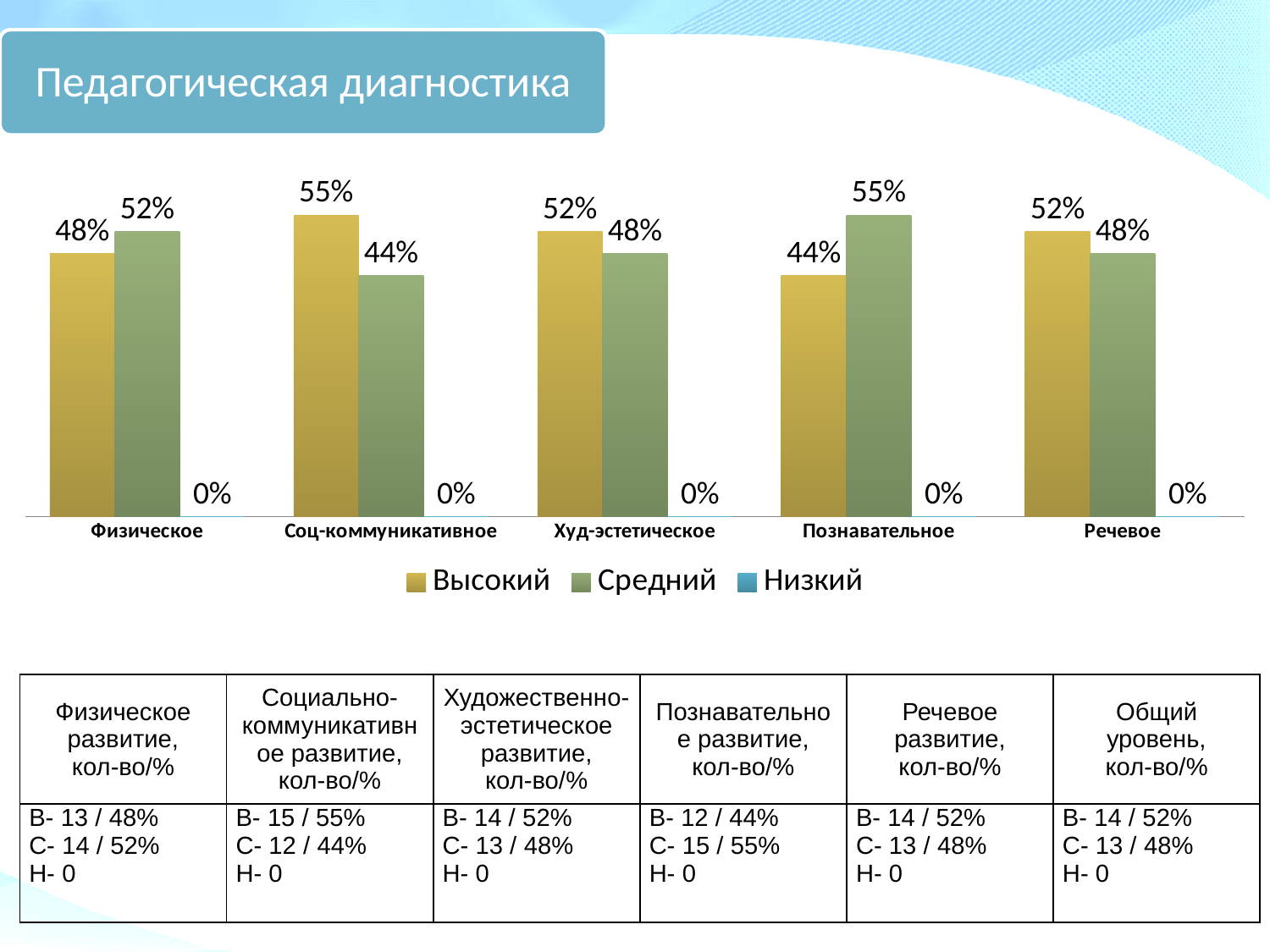
For Худ-эстетическое, which is larger: Высокий or Средний? Высокий Which series is shown in green in the chart? Средний How many series does the chart legend list? 3 What is the value of Высокий for Физическое? 48% What is the value of Низкий for Речевое? 0% What is the value of Средний for Познавательное? 55% Which category has the highest value for Средний? Познавательное What is the value of Высокий for Соц-коммуникативное? 55% Which category has the lowest value for Высокий? Познавательное What is the difference between Высокий and Средний for Соц-коммуникативное? 11% How many categories are shown on the x axis of the chart? 5 What type of chart is shown on the slide? bar chart